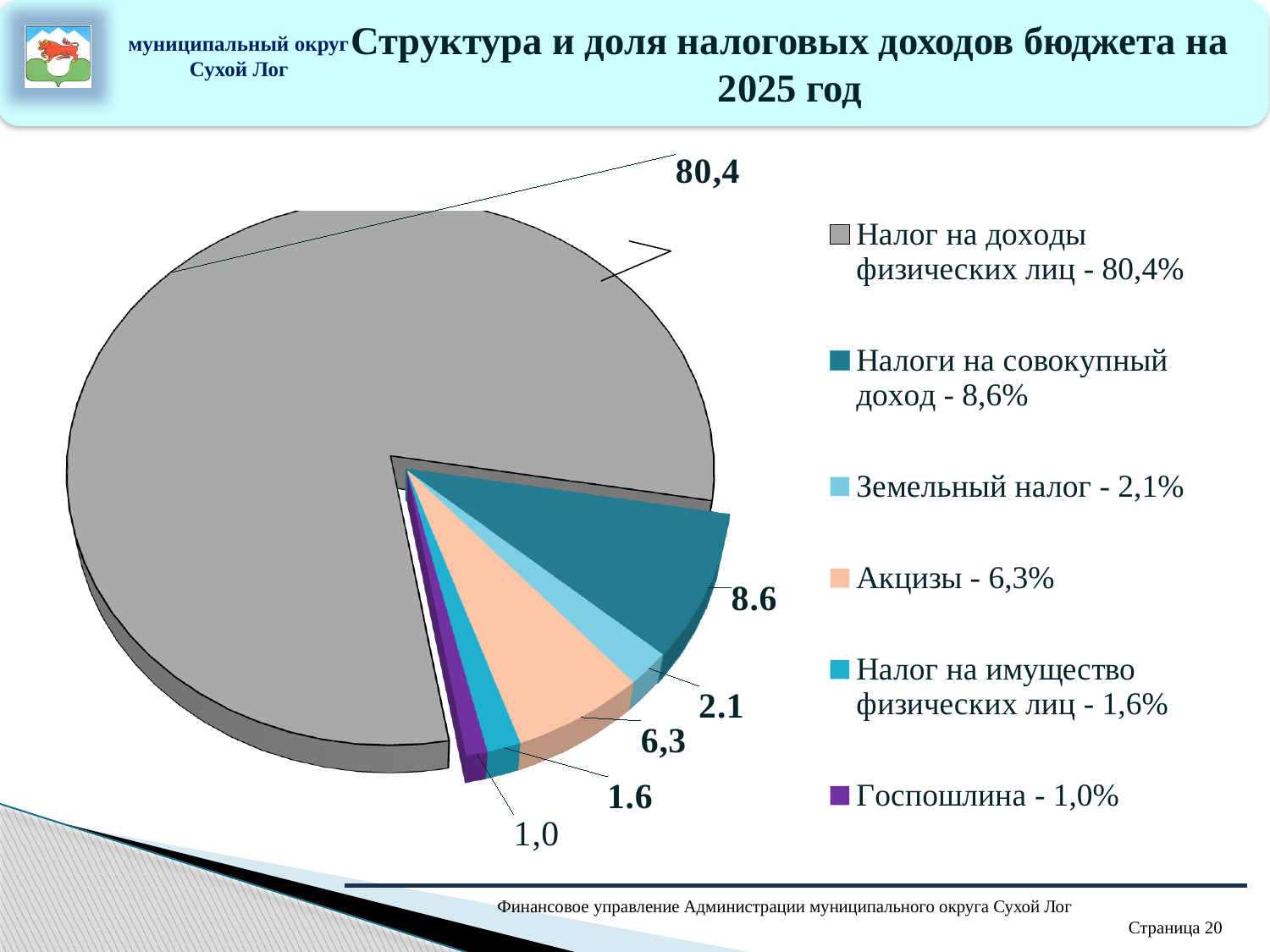
According to the legend, what share is Госпошлина? 1,0% Which is larger, the share of Акцизы or the share of Земельный налог? Акцизы How many entries does the legend list? 6 Which category has the smallest slice of the pie? Госпошлина What kind of chart is shown on the slide? pie chart According to the legend, what share is Налоги на совокупный доход? 8,6% What is the difference in percentage points between Налоги на совокупный доход (8,6%) and Налог на имущество физических лиц (1,6%)? 7,0 How many slices does the pie chart have? 6 Which category has the largest slice of the pie? Налог на доходы физических лиц According to the legend, what share of tax revenues is Налог на доходы физических лиц? 80,4%